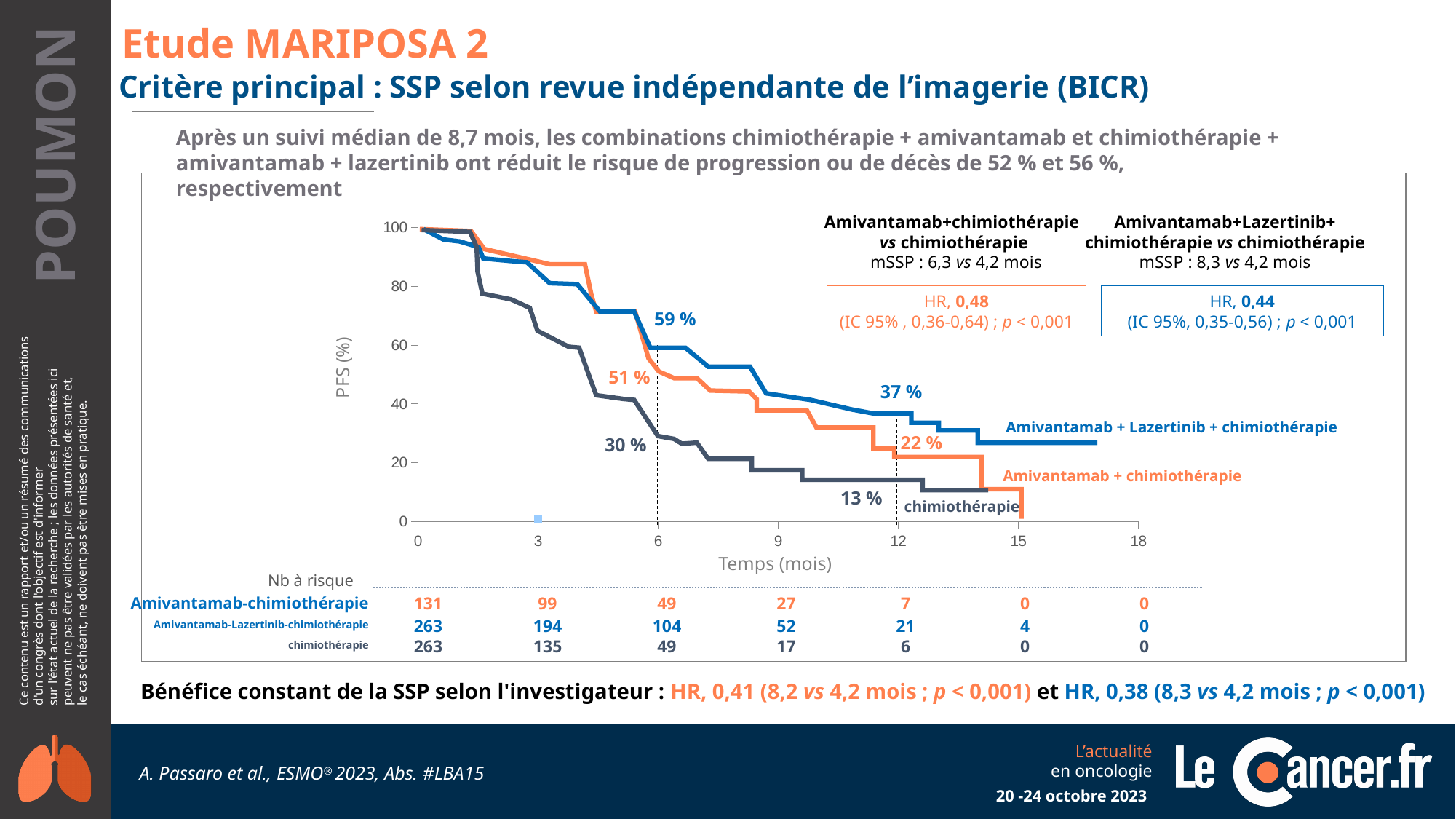
What is the hazard ratio for Amivantamab+Lazertinib+chimiothérapie vs chimiothérapie? 0,44 What is the PFS rate at 6 months for the Amivantamab + chimiothérapie arm? 51 % Which arm has the lowest PFS rate at 6 months? chimiothérapie What is the PFS rate at 6 months for the Amivantamab + Lazertinib + chimiothérapie arm? 59 % What is the PFS rate at 12 months for the Amivantamab + chimiothérapie arm? 22 % Which arm has the highest PFS rate at 12 months? Amivantamab + Lazertinib + chimiothérapie How many patients were at risk at 0 months in the Amivantamab-chimiothérapie arm? 131 How many treatment arms are plotted on the chart? 3 What type of chart is shown on the slide? Kaplan-Meier survival curve (line chart) How many patients were at risk at 6 months in the Amivantamab-Lazertinib-chimiothérapie arm? 104 What is the PFS rate at 12 months for the chimiothérapie arm? 13 % What is the difference in PFS rate at 6 months between the Amivantamab + Lazertinib + chimiothérapie arm and the chimiothérapie arm? 29 %